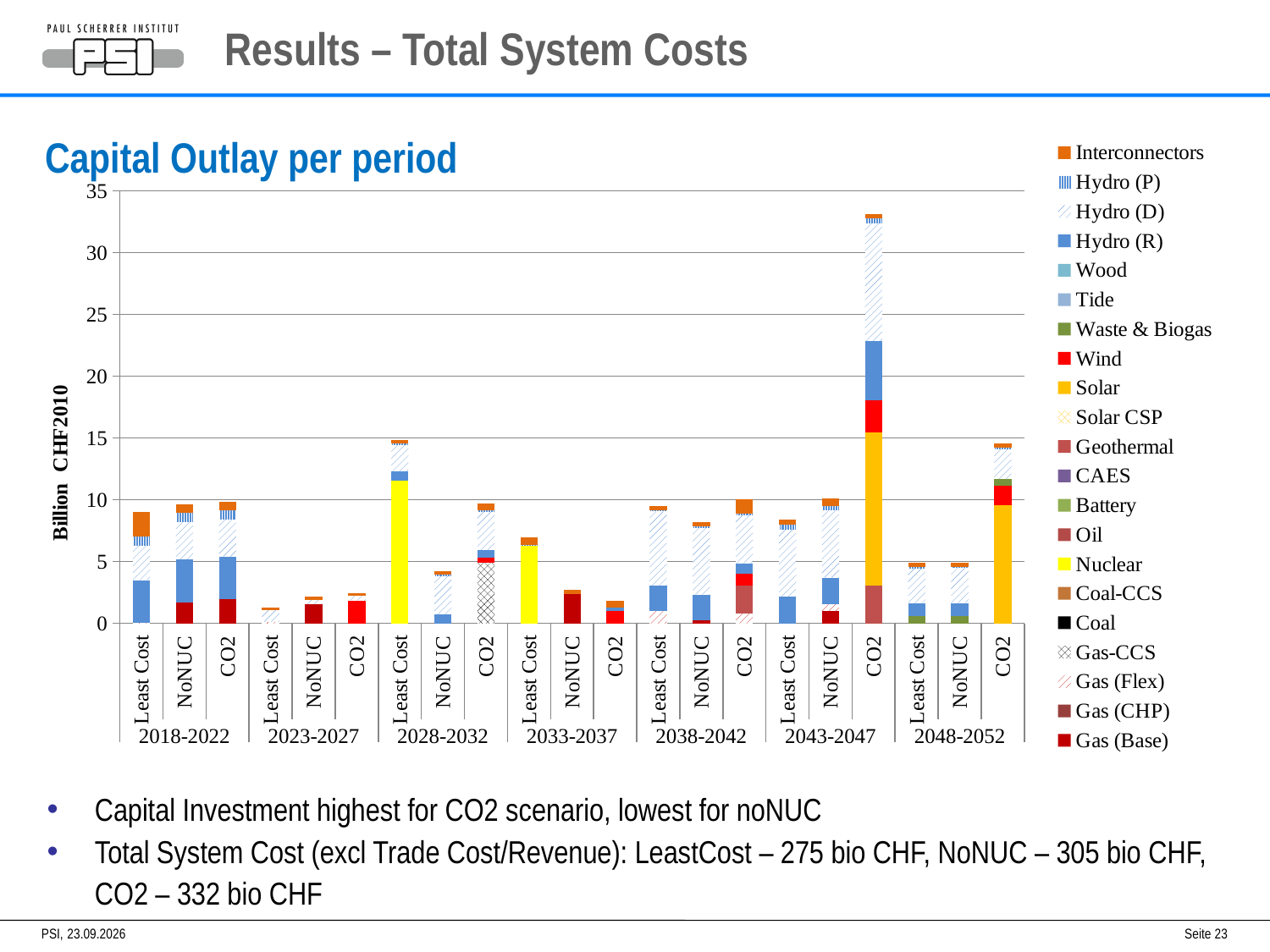
Is the total for CO2 in 2048-2052 greater or less than 10? greater What is the title of the chart? Capital Outlay per period Which bar has the highest total capital outlay? CO2 in 2043-2047 Is the total for CO2 in 2043-2047 greater or less than 30? greater Which bar has the lowest total capital outlay? Least Cost in 2023-2027 What type of chart is shown on the slide? Stacked bar chart Is the total for Least Cost in 2023-2027 greater or less than 5? less How many time periods are shown along the x axis? 7 How many series does the legend list? 21 How many bars are plotted in the chart in total? 21 In the 2028-2032 period, which is larger: the Least Cost bar or the NoNUC bar? Least Cost What is the label of the vertical axis of the chart? Billion CHF2010